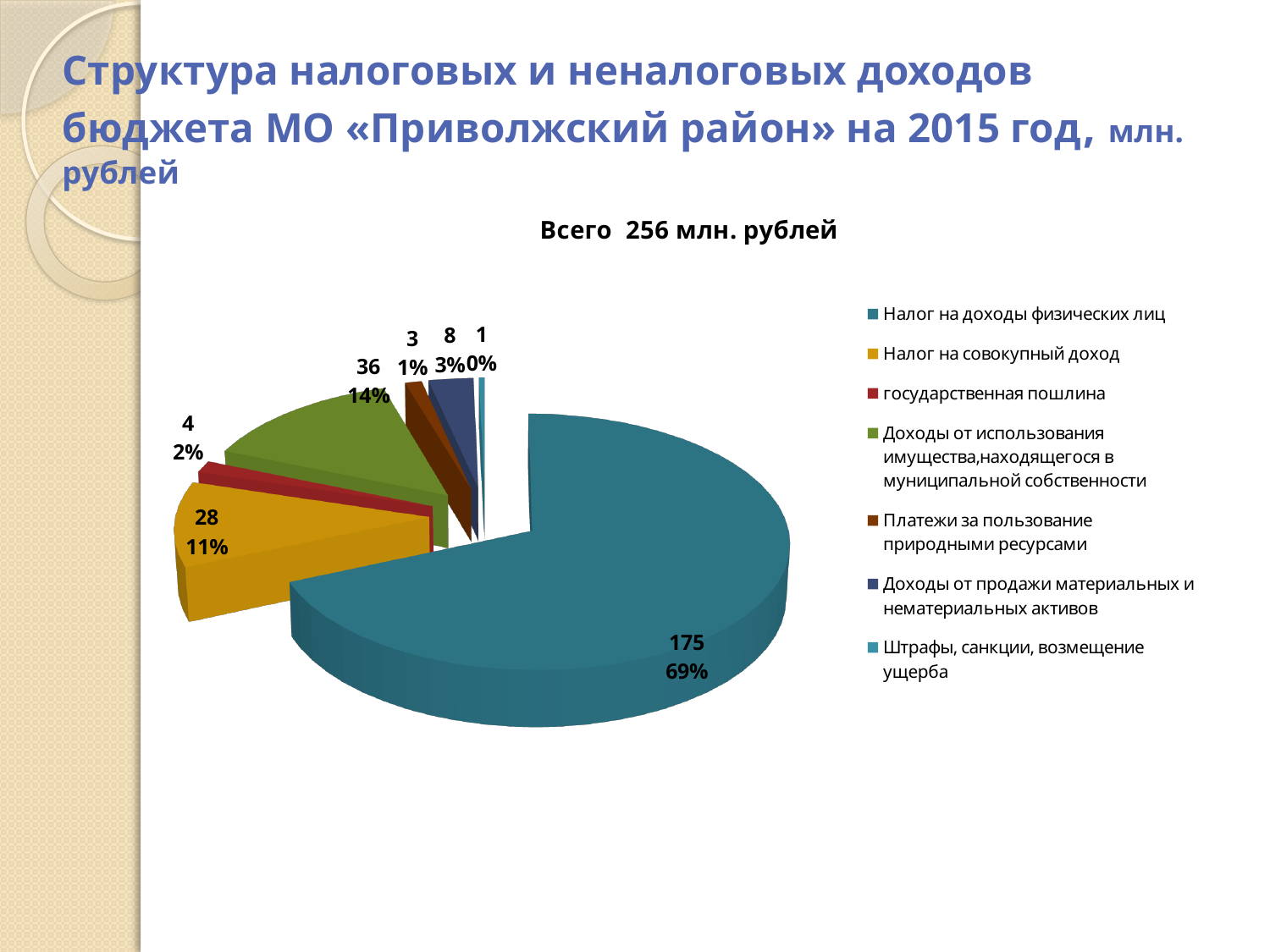
What is the value for Налог на совокупный доход? 28 What is the difference between the values for Налог на доходы физических лиц and Налог на совокупный доход? 147 What share of the pie does Доходы от использования имущества, находящегося в муниципальной собственности represent? 14% What is the value for Доходы от продажи материальных и нематериальных активов? 8 How many categories does the legend list? 7 What share of the pie does Налог на доходы физических лиц represent? 69% What is the value for Налог на доходы физических лиц? 175 What is the value for государственная пошлина? 4 What kind of chart is shown on the slide? pie chart Which is larger: the value for Доходы от использования имущества, находящегося в муниципальной собственности or the value for Налог на совокупный доход? Доходы от использования имущества, находящегося в муниципальной собственности Which category has the largest slice of the pie? Налог на доходы физических лиц Which category has the smallest slice of the pie? Штрафы, санкции, возмещение ущерба